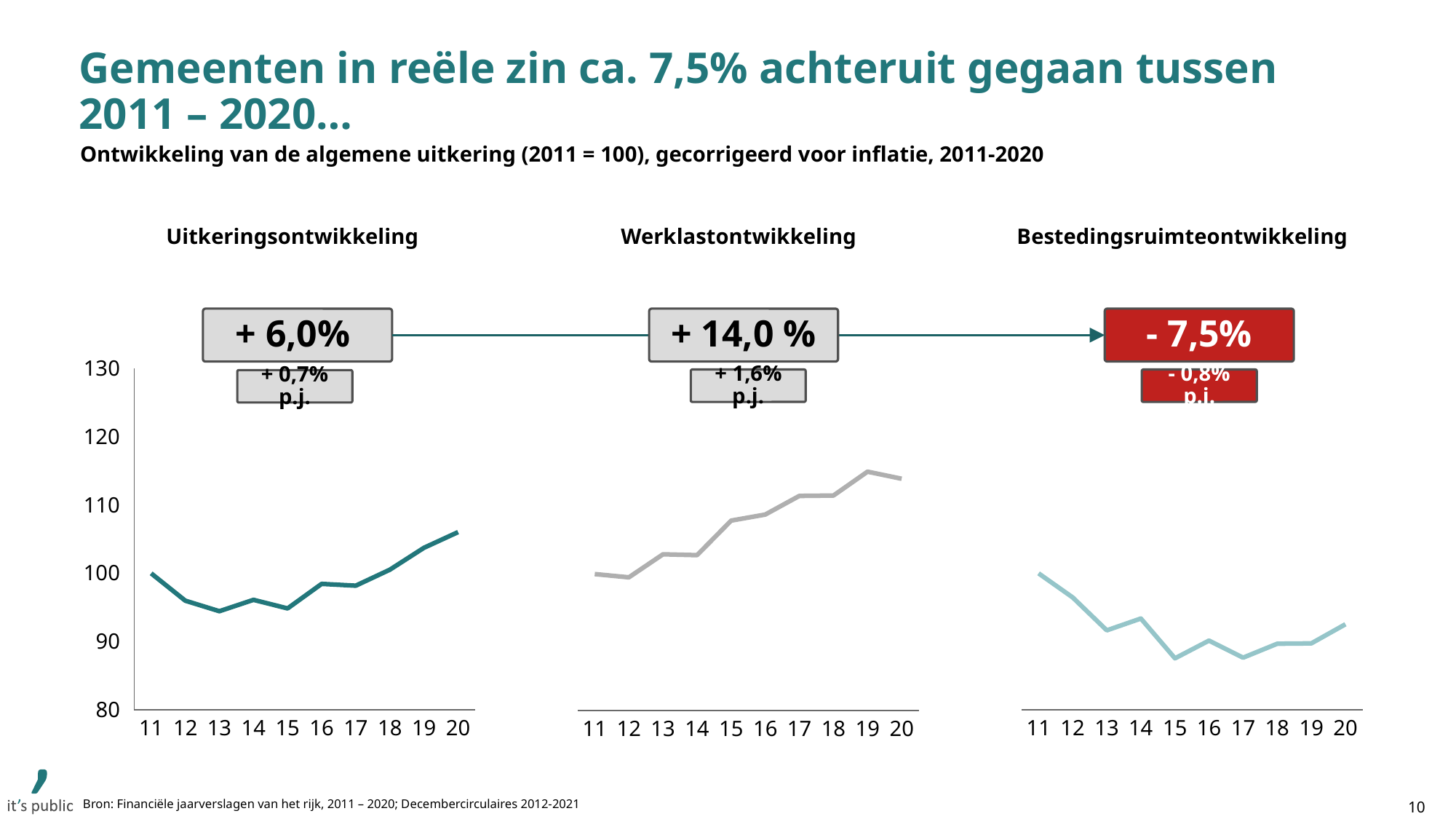
In the Werklastontwikkeling chart, does the line rise or fall from 11 to 20? rise In the Werklastontwikkeling chart, is the value for 19 greater or less than 110? greater What kind of chart is the Uitkeringsontwikkeling chart? line chart Which is larger at year 20: the value in the Werklastontwikkeling chart or the value in the Uitkeringsontwikkeling chart? Werklastontwikkeling How many years are plotted on the x axis of the Werklastontwikkeling chart? 10 In the Bestedingsruimteontwikkeling chart, does the line rise or fall from 11 to 20? fall What change per year (p.j.) is shown above the Bestedingsruimteontwikkeling chart? - 0,8% p.j. In the Bestedingsruimteontwikkeling chart, is the value for 15 greater or less than 90? less What total change is shown in the box above the Werklastontwikkeling chart? + 14,0 % How many line charts are shown on the slide? 3 In the Uitkeringsontwikkeling chart, is the value for 20 greater or less than 100? greater